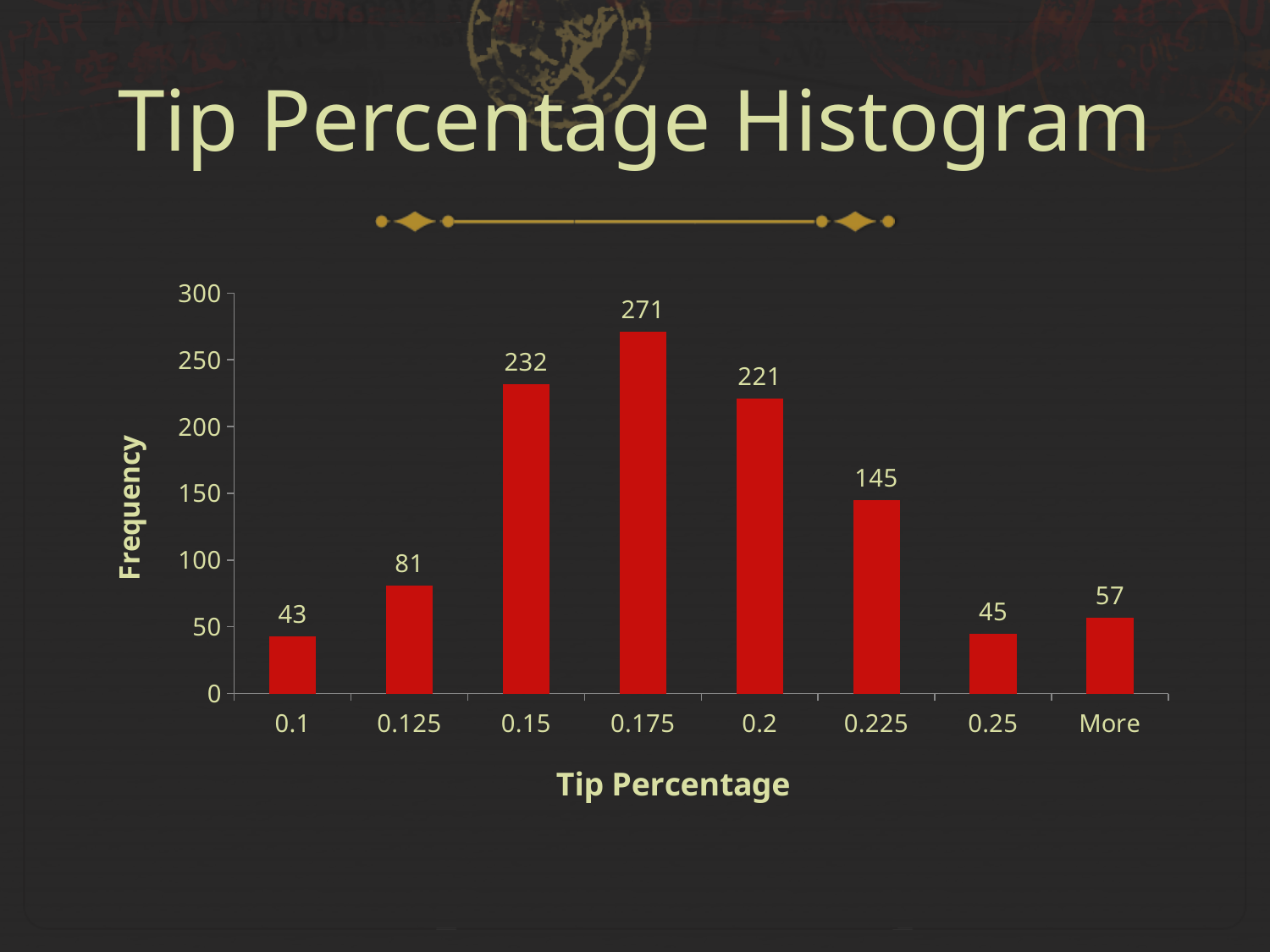
What kind of chart is shown on the slide? bar chart What is the difference in frequency between the 0.15 bin and the 0.2 bin? 11 Which has a higher frequency, the 0.125 bin or the 0.25 bin? 0.125 How many bins are shown on the x axis? 8 What is the frequency for the 0.175 tip percentage bin? 271 Which tip percentage bin has the lowest frequency? 0.1 What is the difference in frequency between the 0.175 bin and the 0.225 bin? 126 Which tip percentage bin has the highest frequency? 0.175 What is the frequency for the 'More' bin? 57 What is the label of the y axis? Frequency Is the frequency for the 0.225 bin greater or less than 100? greater What is the frequency for the 0.1 tip percentage bin? 43